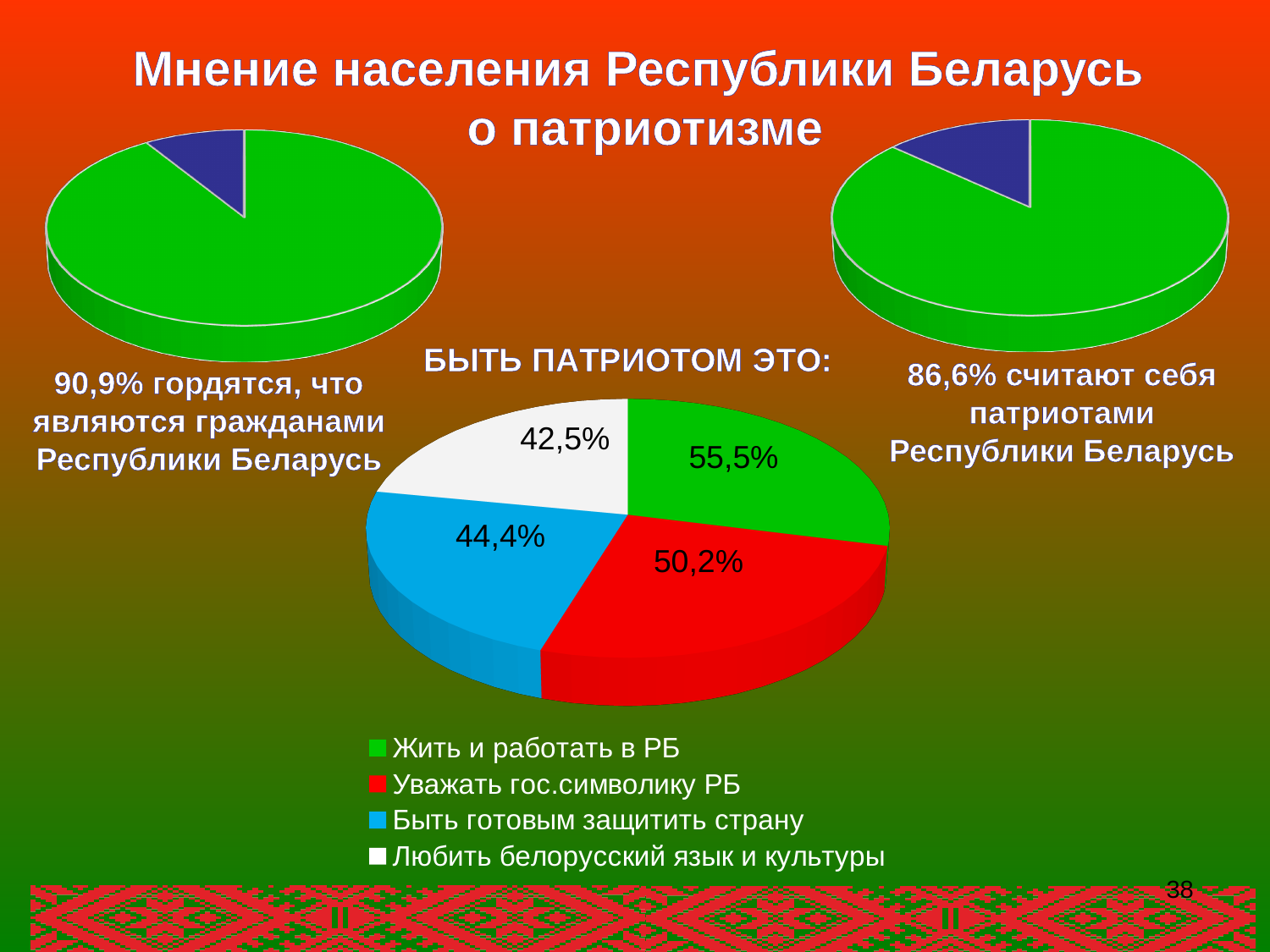
What kind of chart is the central chart titled "БЫТЬ ПАТРИОТОМ ЭТО:"? Pie chart According to the caption under the top-left pie chart, what percentage are proud to be citizens of the Republic of Belarus? 90,9% On the central chart titled "БЫТЬ ПАТРИОТОМ ЭТО:", which is larger: "Уважать гос.символику РБ" or "Быть готовым защитить страну"? Уважать гос.символику РБ On the central chart titled "БЫТЬ ПАТРИОТОМ ЭТО:", what value is shown for "Уважать гос.символику РБ"? 50,2% On the central chart titled "БЫТЬ ПАТРИОТОМ ЭТО:", what value is shown for "Любить белорусский язык и культуры"? 42,5% According to the caption under the top-right pie chart, what percentage consider themselves patriots of the Republic of Belarus? 86,6% On the central chart titled "БЫТЬ ПАТРИОТОМ ЭТО:", what is the difference between the values for "Жить и работать в РБ" and "Любить белорусский язык и культуры"? 13,0% How many categories does the legend of the central chart titled "БЫТЬ ПАТРИОТОМ ЭТО:" list? 4 On the central chart titled "БЫТЬ ПАТРИОТОМ ЭТО:", which category has the highest value? Жить и работать в РБ On the central chart titled "БЫТЬ ПАТРИОТОМ ЭТО:", what value is shown for "Быть готовым защитить страну"? 44,4% On the central chart titled "БЫТЬ ПАТРИОТОМ ЭТО:", what value is shown for "Жить и работать в РБ"? 55,5% On the central chart titled "БЫТЬ ПАТРИОТОМ ЭТО:", which category has the lowest value? Любить белорусский язык и культуры